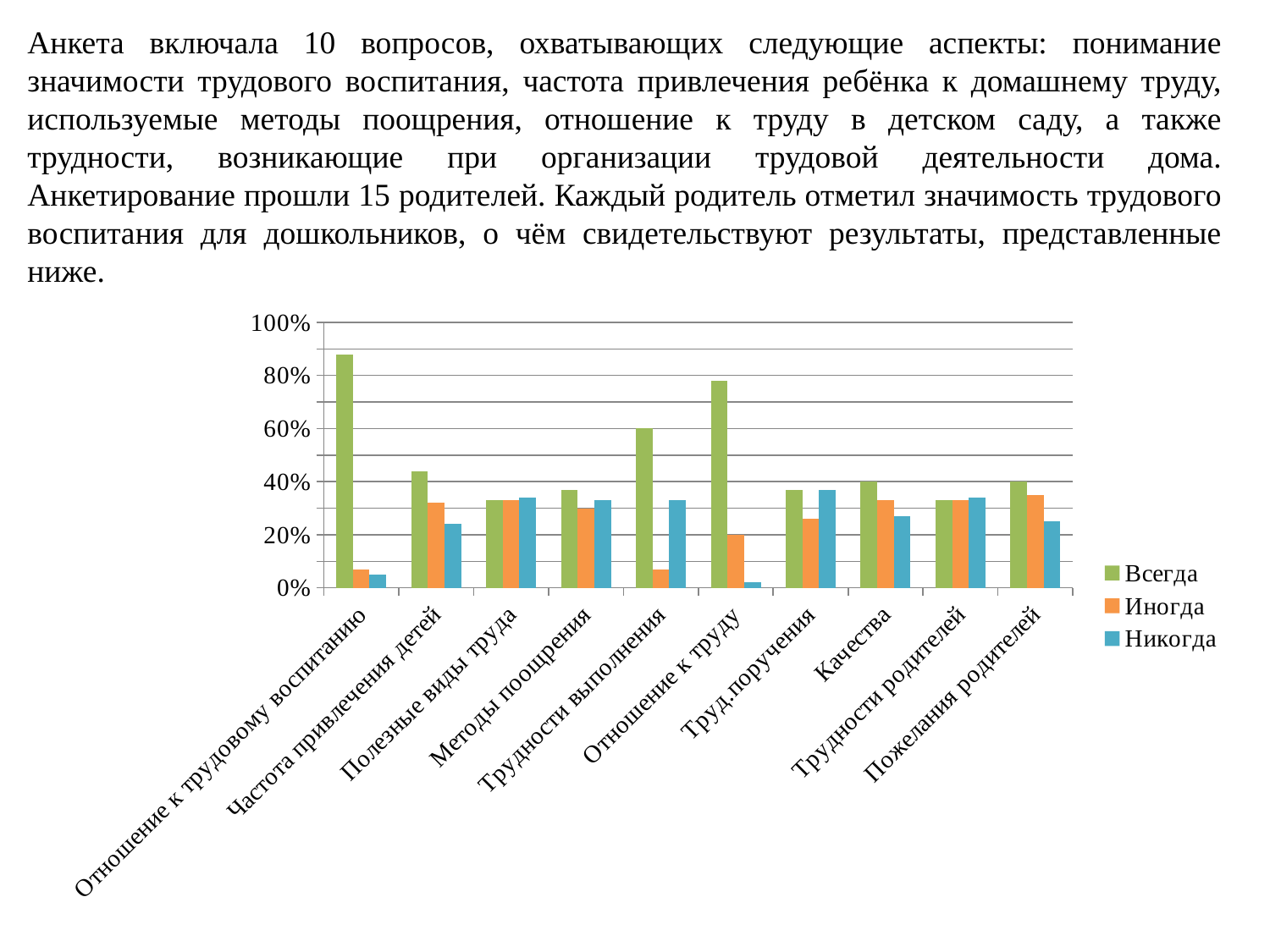
For which category is the 'Всегда' value the highest? Отношение к трудовому воспитанию How many categories are shown on the x axis of the chart? 10 What kind of chart is shown on the slide? bar chart For which category is the 'Никогда' value the lowest? Отношение к труду How many series does the chart legend list? 3 Is the 'Всегда' value for 'Отношение к трудовому воспитанию' greater or less than 80%? greater For 'Частота привлечения детей', which is larger: the 'Всегда' value or the 'Никогда' value? Всегда Which series are listed in the chart legend? Всегда, Иногда, Никогда Is the 'Всегда' value for 'Трудности выполнения' greater or less than 40%? greater Is the 'Всегда' value for 'Отношение к труду' greater or less than 60%? greater For 'Отношение к труду', which is larger: the 'Иногда' value or the 'Никогда' value? Иногда